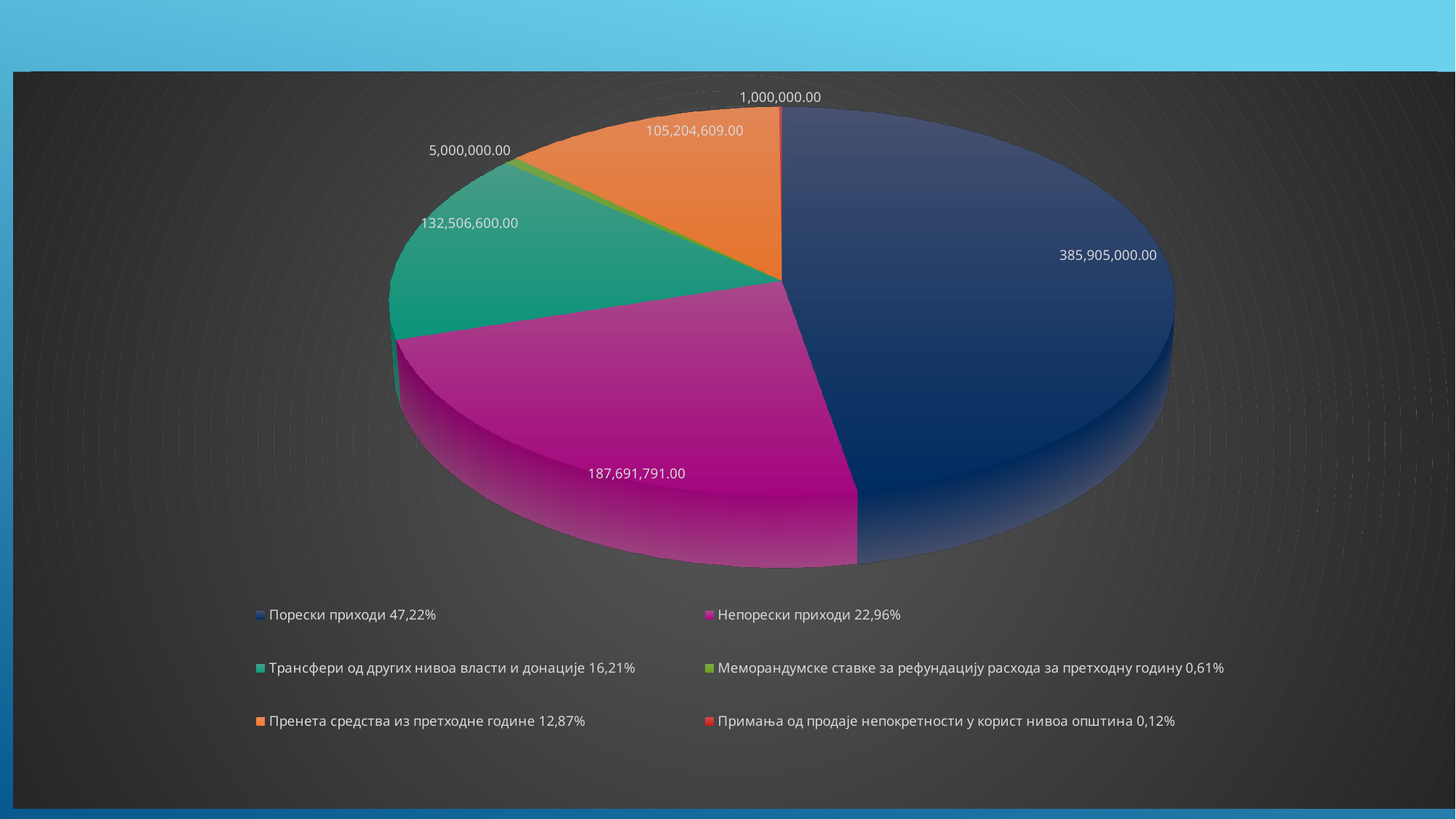
What is the value of the slice for Непорески приходи? 187,691,791.00 How many slices does the pie chart have? 6 Which category has the smallest slice of the pie? Примања од продаје непокретности у корист нивоа општина What is the value of the slice for Меморандумске ставке за рефундацију расхода за претходну годину? 5,000,000.00 What is the value of the slice for Порески приходи? 385,905,000.00 What is the difference between the value for Порески приходи and the value for Непорески приходи? 198,213,209.00 What kind of chart is shown on the slide? pie chart Which category has the largest slice of the pie? Порески приходи Which is larger: the slice for Трансфери од других нивоа власти и донације or the slice for Пренета средства из претходне године? Трансфери од других нивоа власти и донације What share of the pie does Непорески приходи represent, according to the legend? 22,96% What is the value of the slice for Пренета средства из претходне године? 105,204,609.00 What is the value of the slice for Трансфери од других нивоа власти и донације? 132,506,600.00